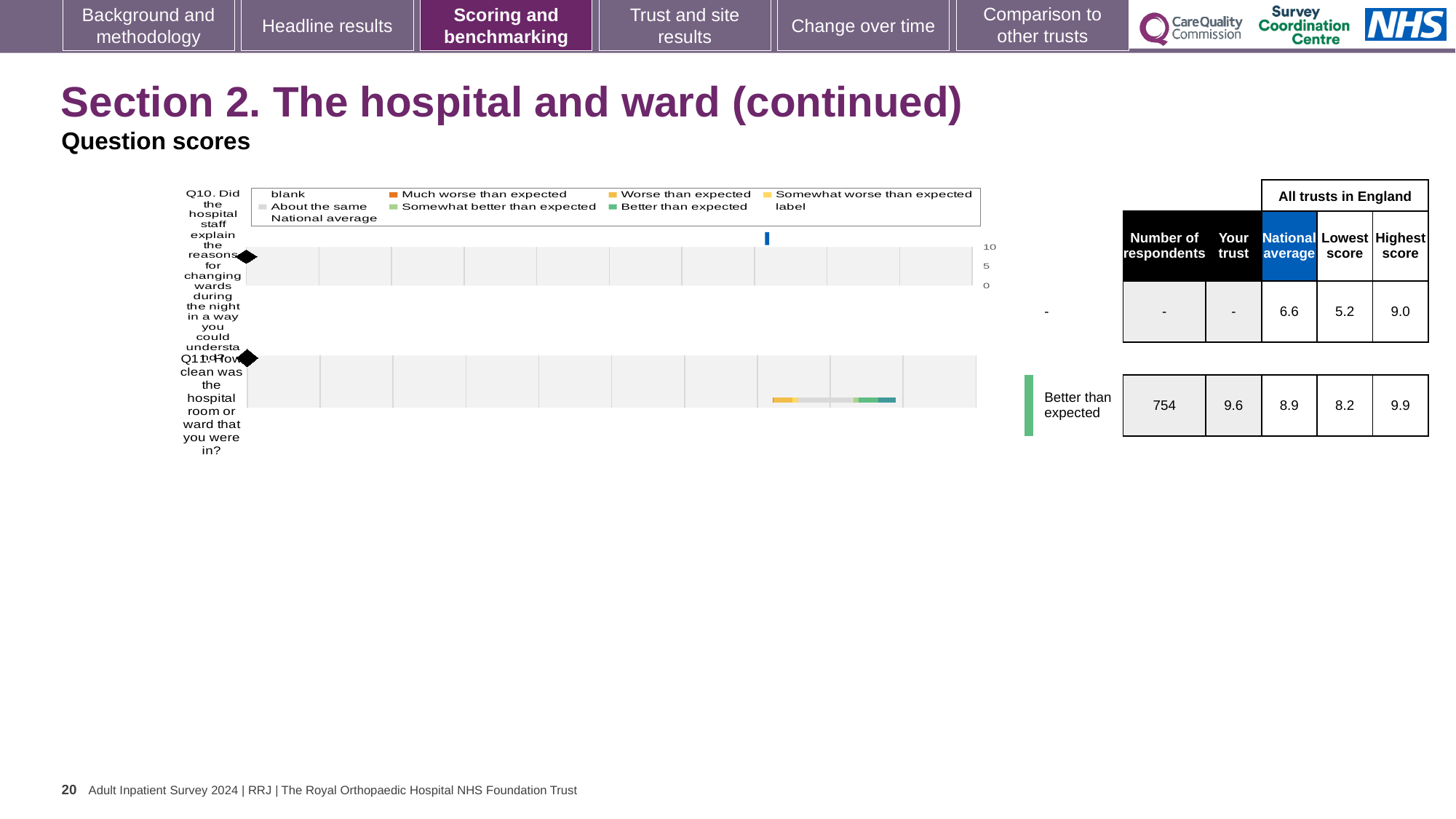
In the table, what is the highest score among all trusts in England for Q10? 9.0 Which is larger for Q11: the trust's score or the national average? the trust's score In the table, what is the 'Your trust' score for Q11 (How clean was the hospital room or ward that you were in?)? 9.6 What kind of chart is shown on the slide? bar chart How many questions (categories) are plotted on the chart? 2 In the table, what is the national average for Q11? 8.9 In the table, how many respondents are listed for Q11? 754 Which legend entry is shown in orange? Much worse than expected What benchmark category is Q11 assigned to on the slide? Better than expected What is the highest value shown on the chart's horizontal axis? 10 In the table, what is the lowest score among all trusts in England for Q10? 5.2 What is the difference between the highest score (9.9) and the lowest score (8.2) for Q11 in the table? 1.7